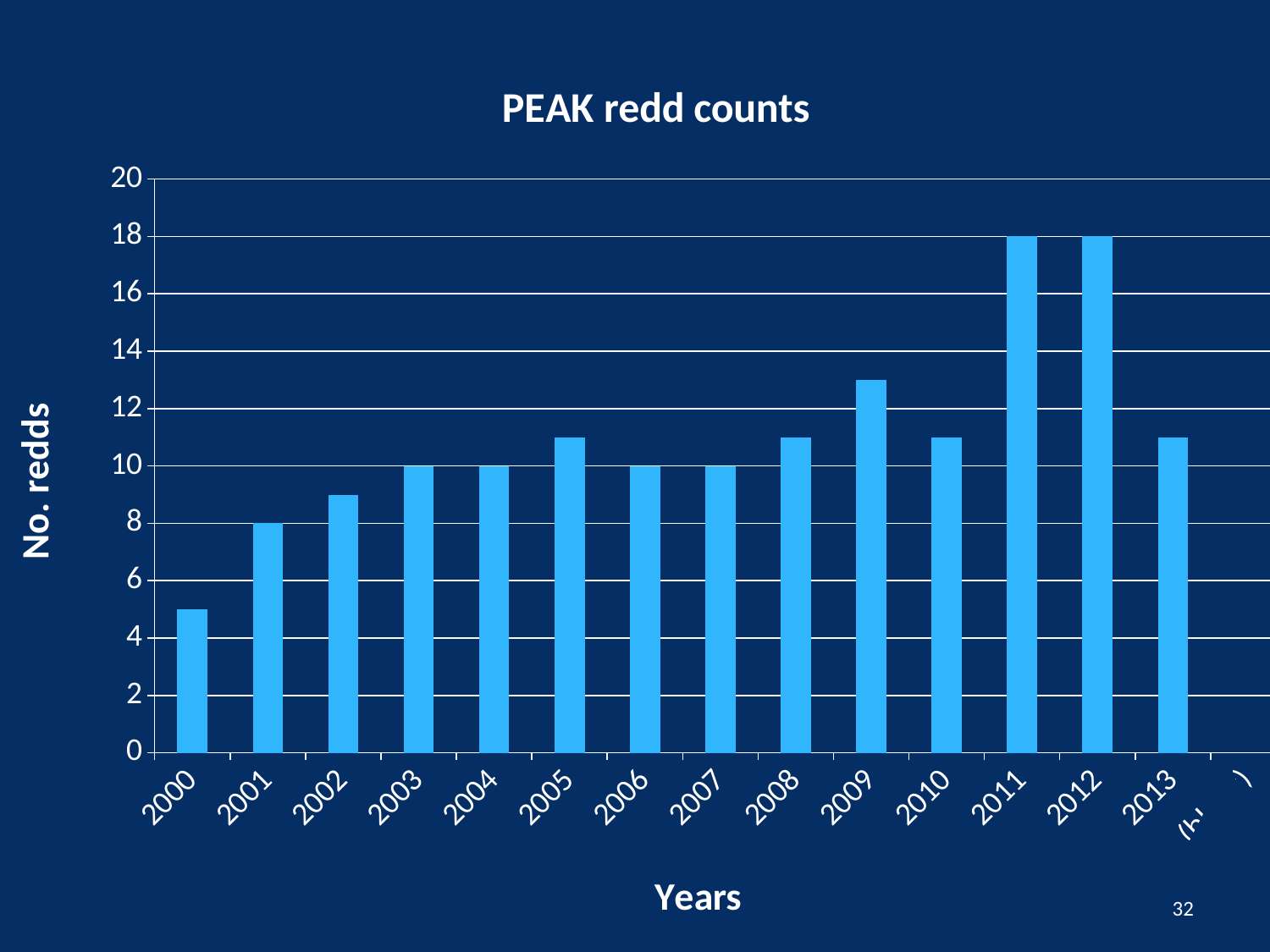
What is the number of redds for 2003? 10 Which years have the highest number of redds? 2011 and 2012 Which year has the lowest number of redds? 2000 Which year has more redds, 2009 or 2002? 2009 Is the value for 2009 greater or less than 12? greater What kind of chart is shown on the slide? bar chart What is the title of the chart? PEAK redd counts What is the number of redds for 2011? 18 What is the label on the vertical axis? No. redds What is the number of redds for 2001? 8 What is the difference in number of redds between 2011 and 2001? 10 Is the value for 2000 greater or less than 6? less